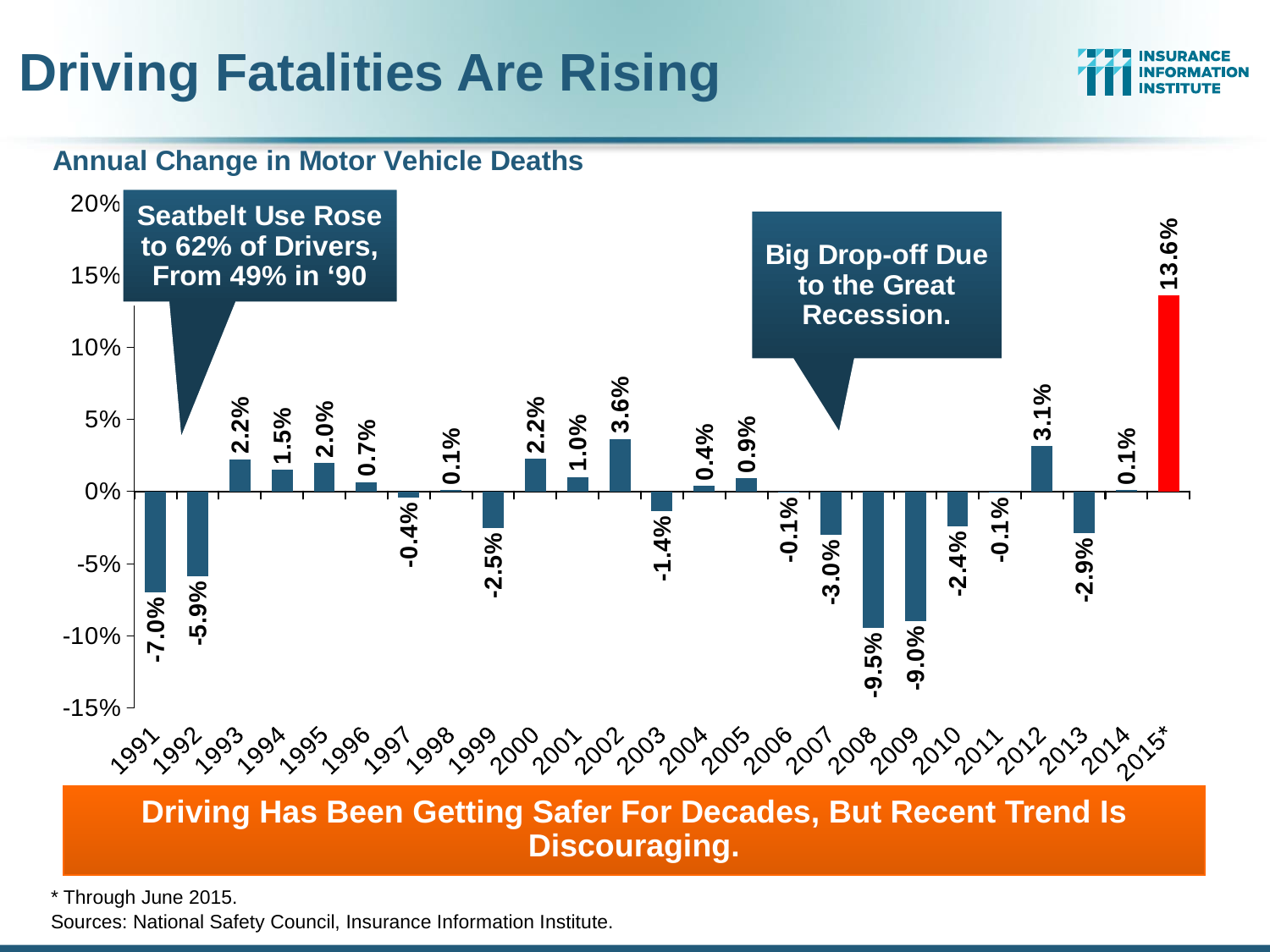
What kind of chart is used to show the annual change in motor vehicle deaths? Bar chart What is the value shown for 2012? 3.1% What is the value shown for 1991? -7.0% Which year has the larger value, 2009 or 2010? 2010 Which year has the lowest annual change in motor vehicle deaths? 2008 Is the value for 2015* greater or less than 10%? greater How many years are shown on the x axis of the chart? 25 What is the annual change in motor vehicle deaths shown for 2015*? 13.6% What is the difference between the values for 2002 and 2012? 0.5% Which year has the highest annual change in motor vehicle deaths? 2015* What is the value shown for 2008? -9.5% What is the title of the chart? Annual Change in Motor Vehicle Deaths